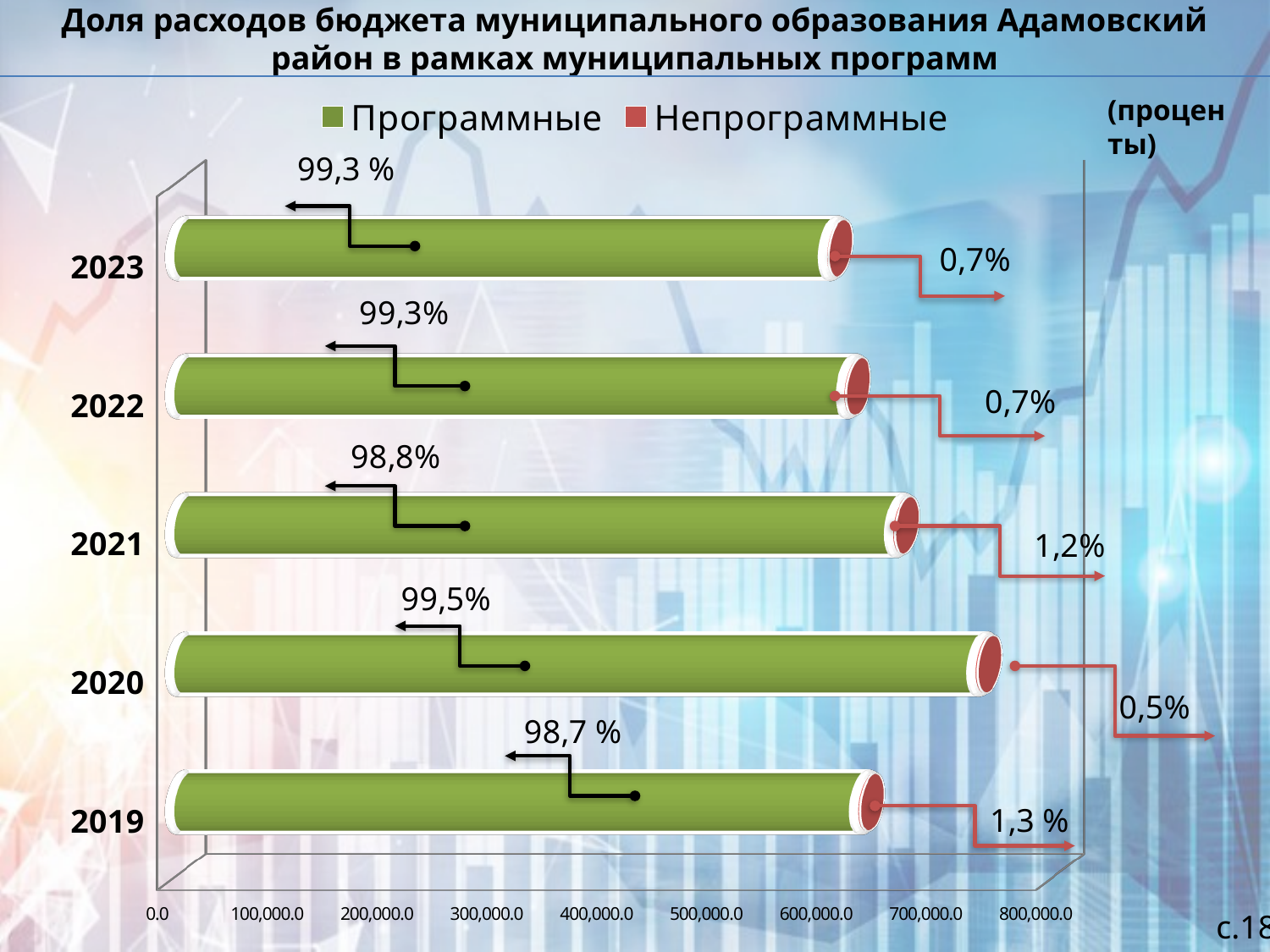
What is the value labelled for Непрограммные in 2021? 1,2% Is the length of the green Программные bar for 2020 greater or less than 700,000.0 on the axis? greater Which year has the larger Непрограммные share, 2019 or 2022? 2019 How many years are shown on the chart? 5 In which year is the Непрограммные share the lowest? 2020 In which year is the Программные share the highest? 2020 What is the value labelled for Непрограммные in 2020? 0,5% What kind of chart is shown on the slide? bar chart How many series does the legend list? 2 What is the value labelled for Программные in 2023? 99,3 % By how many percentage points does the Программные share in 2022 exceed that in 2021? 0,5 What is the value labelled for Программные in 2019? 98,7 %